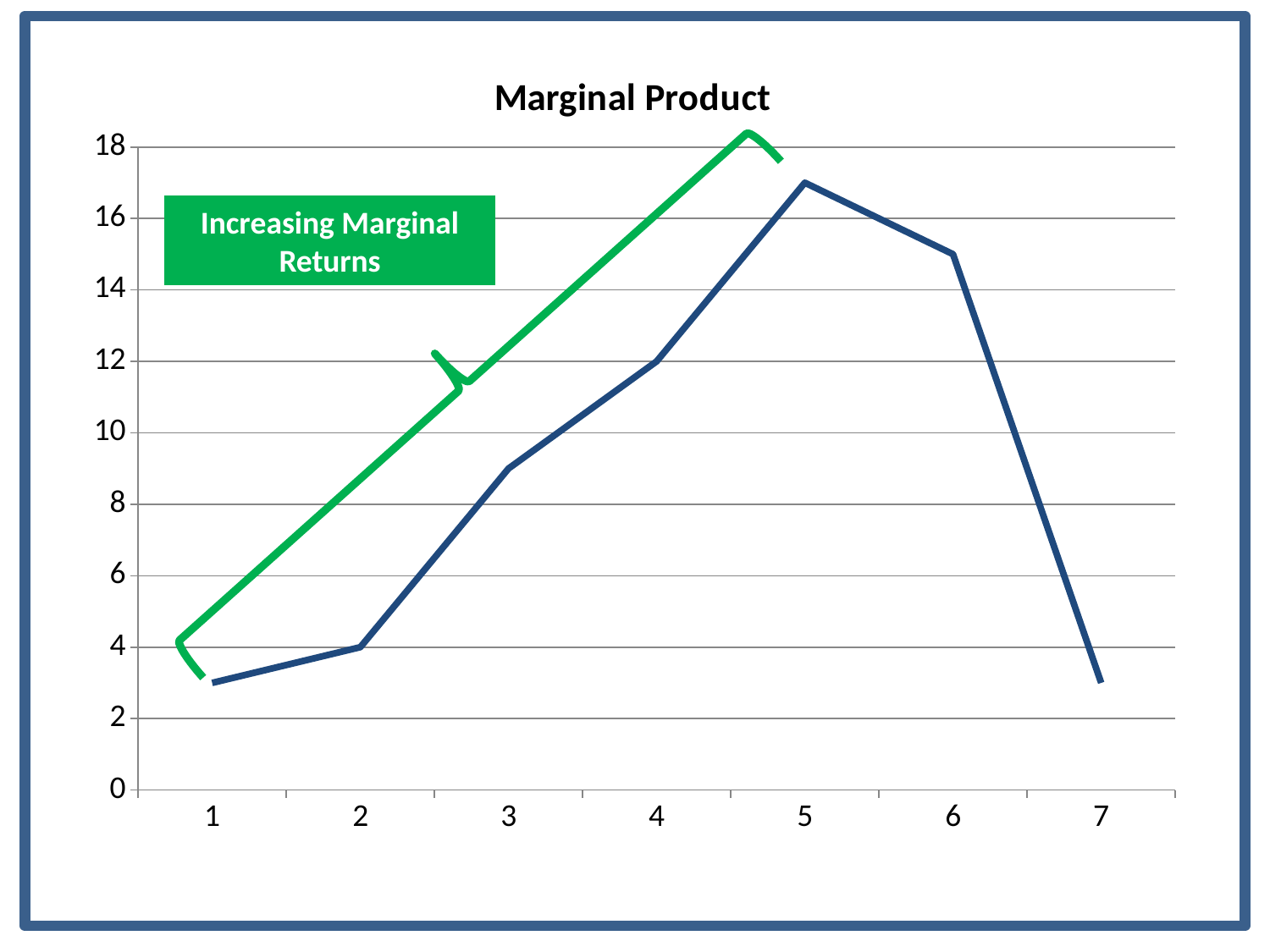
Which is larger, the value at x = 5 or the value at x = 6? x = 5 What is the marginal product value at x = 4? 12 What is the title of the chart? Marginal Product At which x value does the line reach its highest point? 5 Is the value at x = 5 greater or less than 16? greater Is the value at x = 6 greater or less than 14? greater What is the marginal product value at x = 2? 4 Is the value at x = 3 greater or less than 8? greater What kind of chart is shown on the slide? line chart Does the line rise or fall between x = 1 and x = 5? rise How many data points are plotted on the line? 7